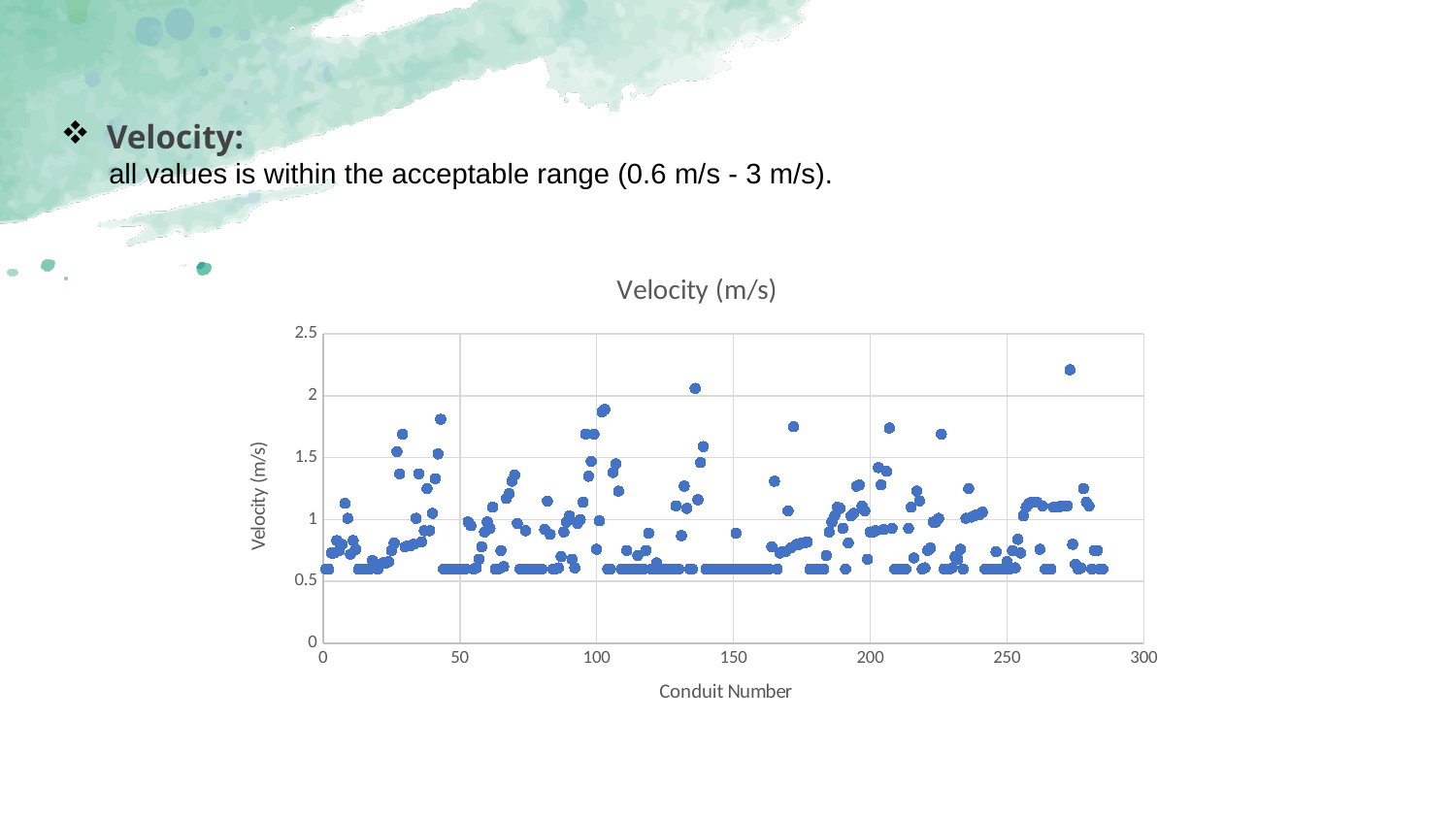
What is the label of the x axis of the chart? Conduit Number Is the highest plotted velocity value on the chart greater or less than 2? greater What is the title of the chart? Velocity (m/s) Is the highest plotted velocity value on the chart greater or less than 2.5? less Is the velocity value of the highest point near conduit number 100 greater or less than 1.5? greater What kind of chart is shown on the slide? scatter chart